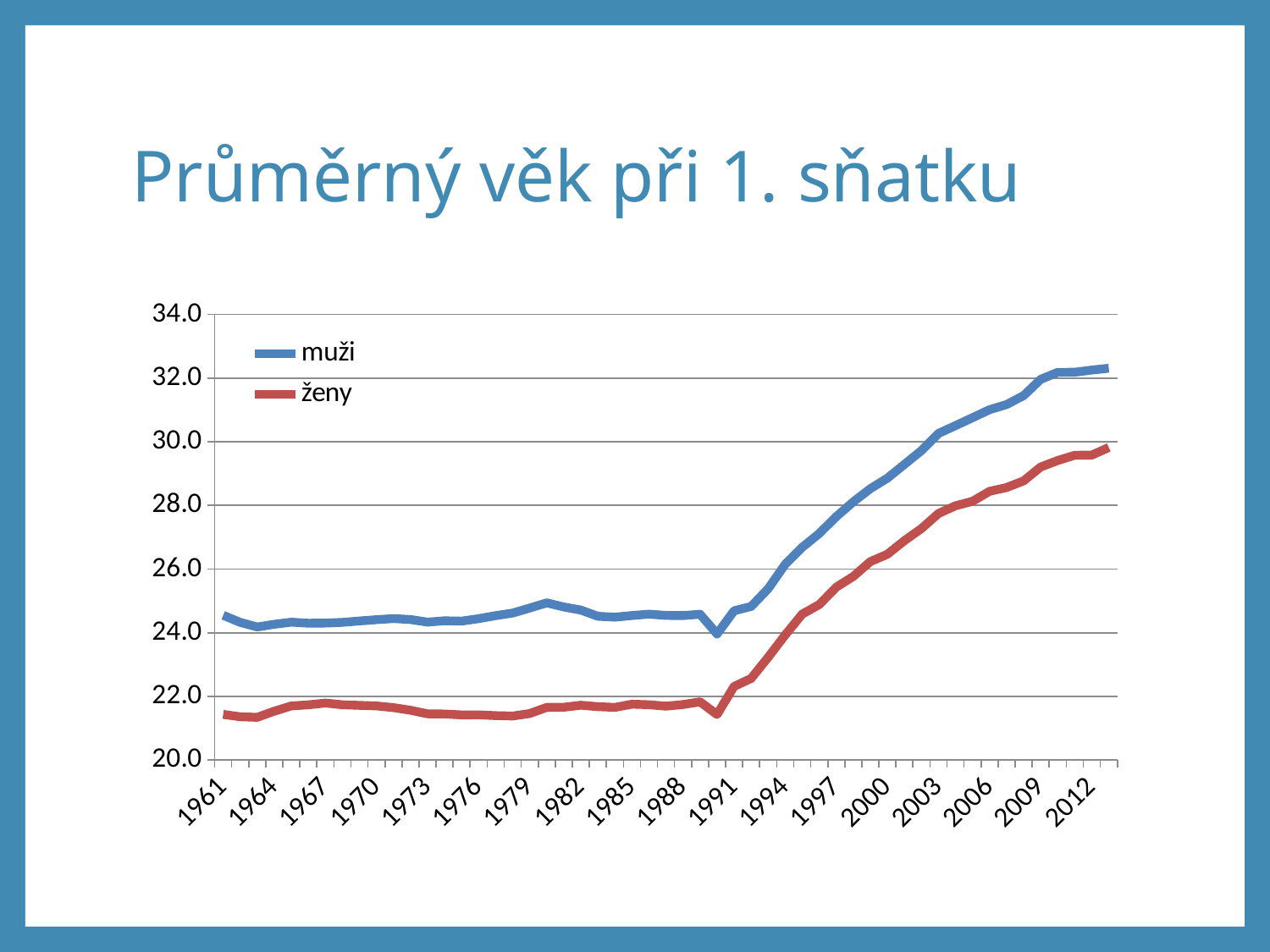
What is the title of the chart? Průměrný věk při 1. sňatku In 2012, which series has the higher value, muži or ženy? muži How many series does the legend list? 2 Is the value for muži in 2012 greater or less than 30.0? greater Is the value for ženy in 1997 greater or less than 26.0? less What kind of chart is shown on the slide? line chart Which is larger, the value for muži in 1961 or the value for muži in 2012? 2012 Do the values for muži rise or fall between 1991 and 2012? rise Is the value for ženy in 1961 greater or less than 22.0? less What are the two series named in the legend? muži and ženy